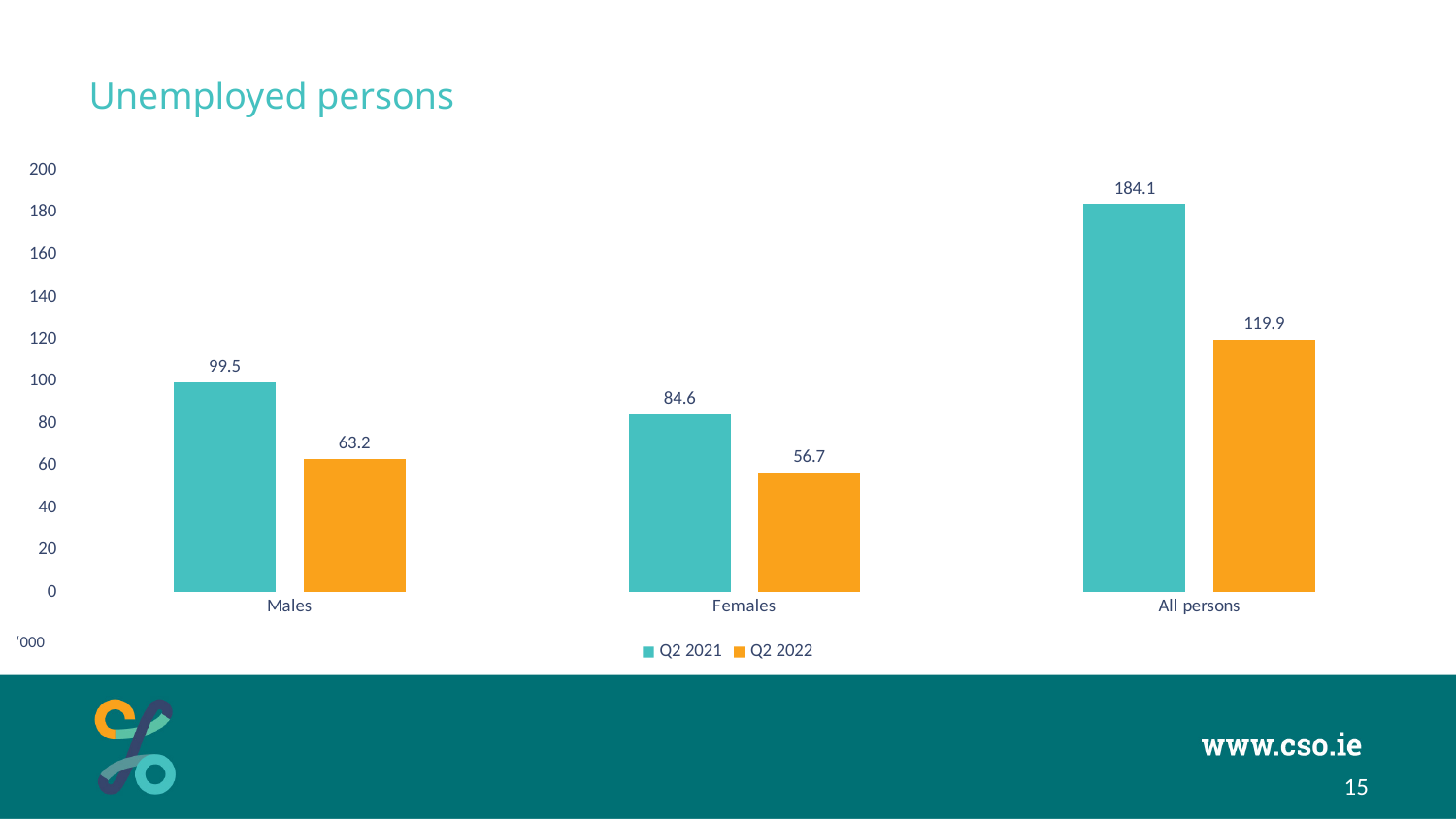
What is the value for All persons in Q2 2021? 184.1 What kind of chart is shown on the slide? Bar chart What is the difference between the Q2 2021 and Q2 2022 values for Males? 36.3 What is the difference between the Q2 2021 and Q2 2022 values for All persons? 64.2 What is the value for Females in Q2 2022? 56.7 What is the value for Males in Q2 2021? 99.5 How many categories are shown on the x axis? 3 Which category has the lowest Q2 2021 value? Females Which category has the highest Q2 2022 value? All persons Which is larger: the Q2 2022 value for Males or the Q2 2022 value for Females? Males Is the Q2 2021 value for Females greater or less than 100? less How many series does the legend list? 2